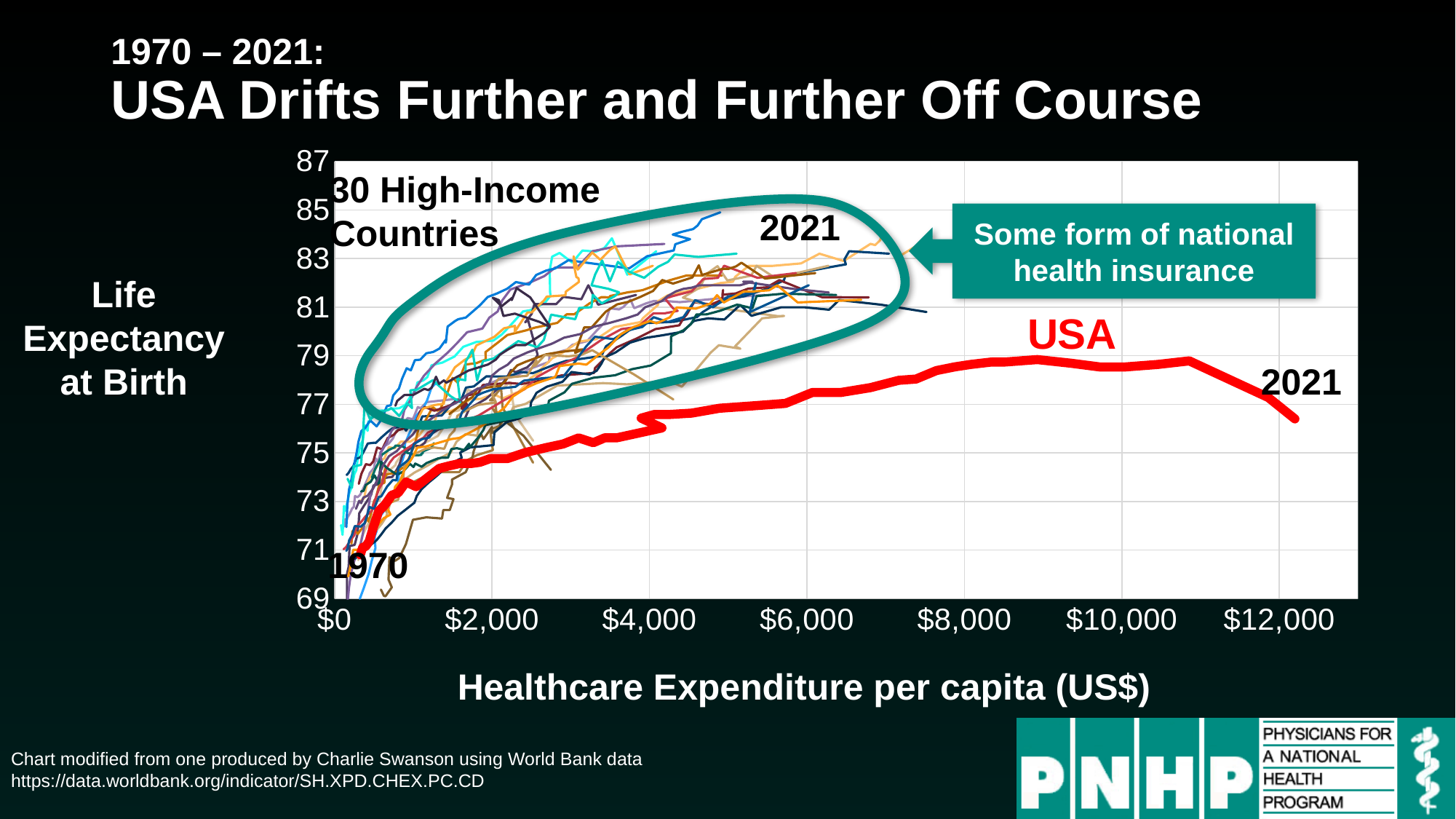
Is the USA healthcare expenditure per capita in 2021 greater or less than $10,000? greater What does the x axis of the chart measure? Healthcare Expenditure per capita (US$) What kind of chart is shown on the slide? line chart What is the title of the chart on the slide? 1970 – 2021: USA Drifts Further and Further Off Course How many high-income countries are plotted in the circled group? 30 What is the highest value shown on the y axis of the chart? 87 Is the USA life expectancy at birth in 1970 greater or less than 73? less Is the USA life expectancy at birth in 2021 greater or less than 77? less Does the USA line rise or fall at its final segment leading to 2021? fall In 2021, is the USA life expectancy higher or lower than that of the 30 high-income countries? lower Is the USA healthcare expenditure per capita in 2021 greater or less than that of any of the 30 high-income countries? greater Which country's line is drawn in thick red? USA